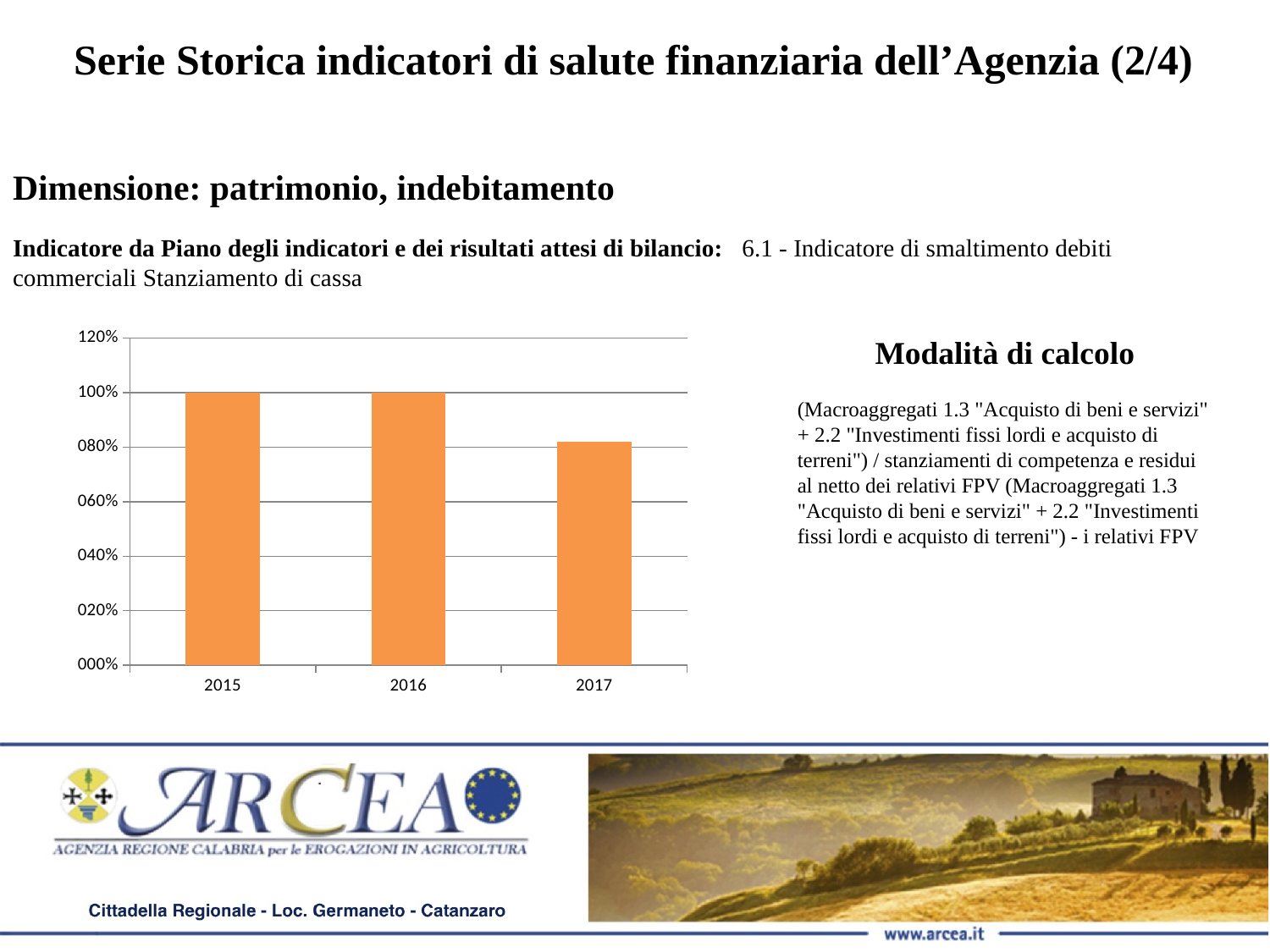
Is the value for 2017 greater or less than 100%? less Do the values rise or fall from 2015 to 2017? fall What colour are the bars in the chart? orange Which year has the lowest value in the chart? 2017 Is the value for 2017 greater or less than 060%? greater How many years are shown on the x axis of the chart? 3 What is the value for 2015 in the chart? 100% What is the highest tick label shown on the y axis of the chart? 120% What kind of chart is shown on the slide? bar chart What is the value for 2016 in the chart? 100% Which is larger, the value for 2016 or the value for 2017? 2016